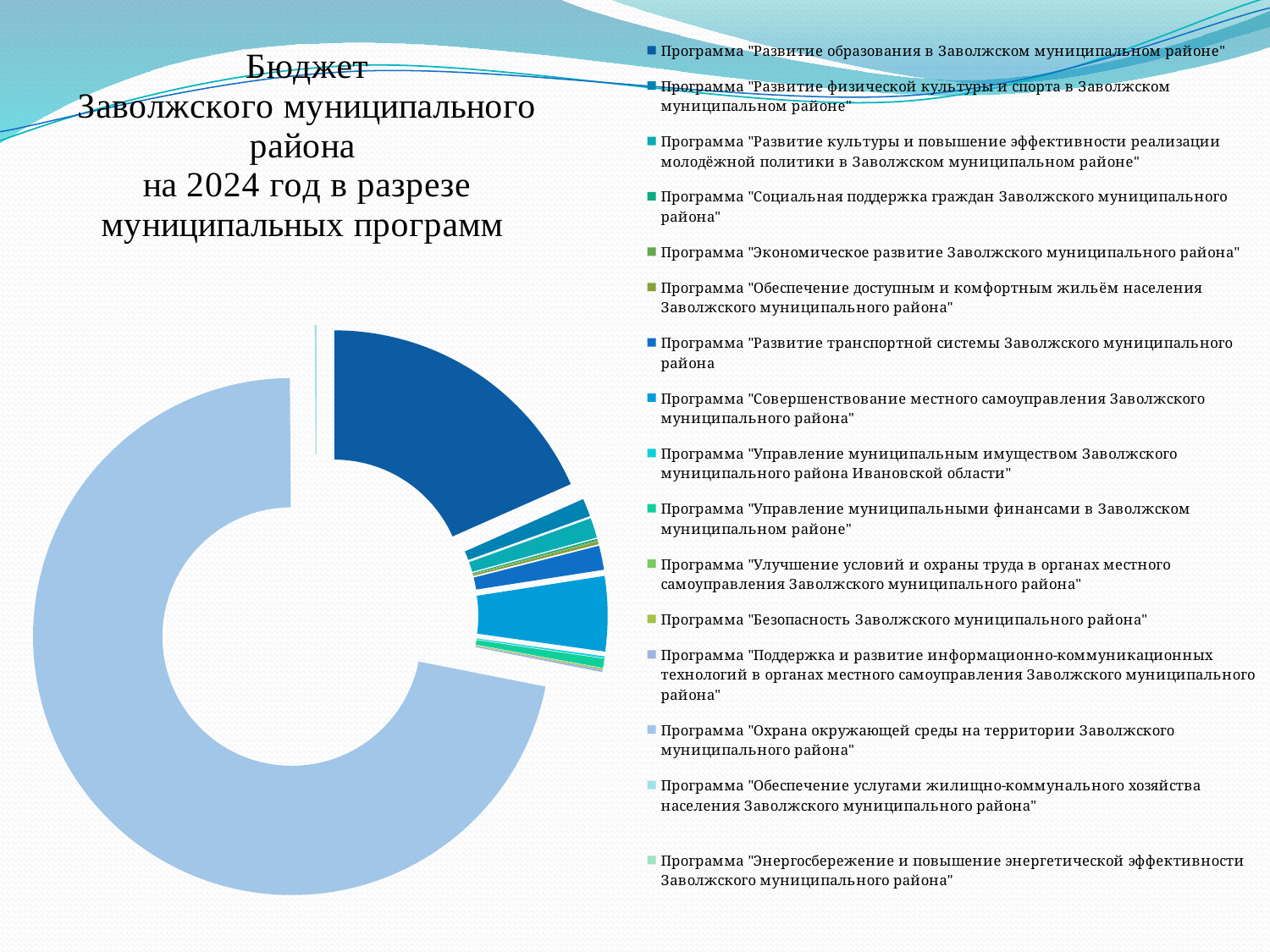
Which year does the budget chart on the slide refer to? 2024 Which is the first programme listed in the chart legend? Программа "Развитие образования в Заволжском муниципальном районе" What kind of chart is shown on the slide? Doughnut (pie) chart How many programmes does the chart legend list? 16 Which slice is larger: the one for "Развитие образования в Заволжском муниципальном районе" or the one for "Развитие физической культуры и спорта в Заволжском муниципальном районе"? Развитие образования в Заволжском муниципальном районе